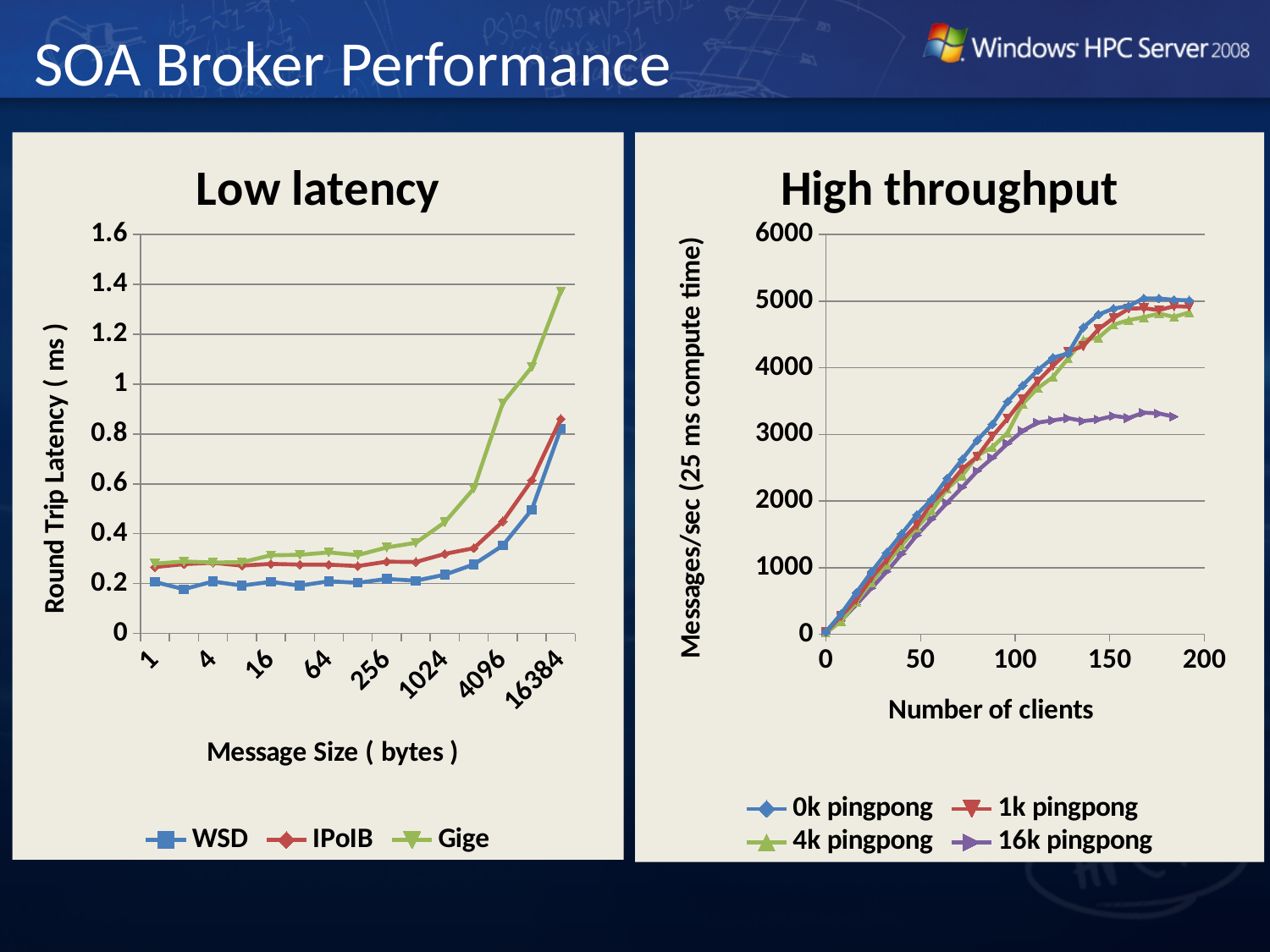
What kind of chart is the High throughput chart? line chart On the Low latency chart, is the WSD value at 1 byte greater or less than 0.4? less On the High throughput chart, which series has the lowest messages/sec at around 180 clients? 16k pingpong On the Low latency chart, how many series does the legend list? 3 On the Low latency chart, which series has the highest round trip latency at a message size of 16384 bytes? Gige What kind of chart is the Low latency chart? line chart On the Low latency chart, which series has the lowest round trip latency at a message size of 1 byte? WSD On the Low latency chart, is the Gige value at 16384 bytes greater or less than 1.2? greater On the High throughput chart, how many series does the legend list? 4 On the High throughput chart, do the messages/sec values for 0k pingpong generally rise or fall as the number of clients increases? rise On the High throughput chart, is the 0k pingpong value at 150 clients greater or less than 4000? greater